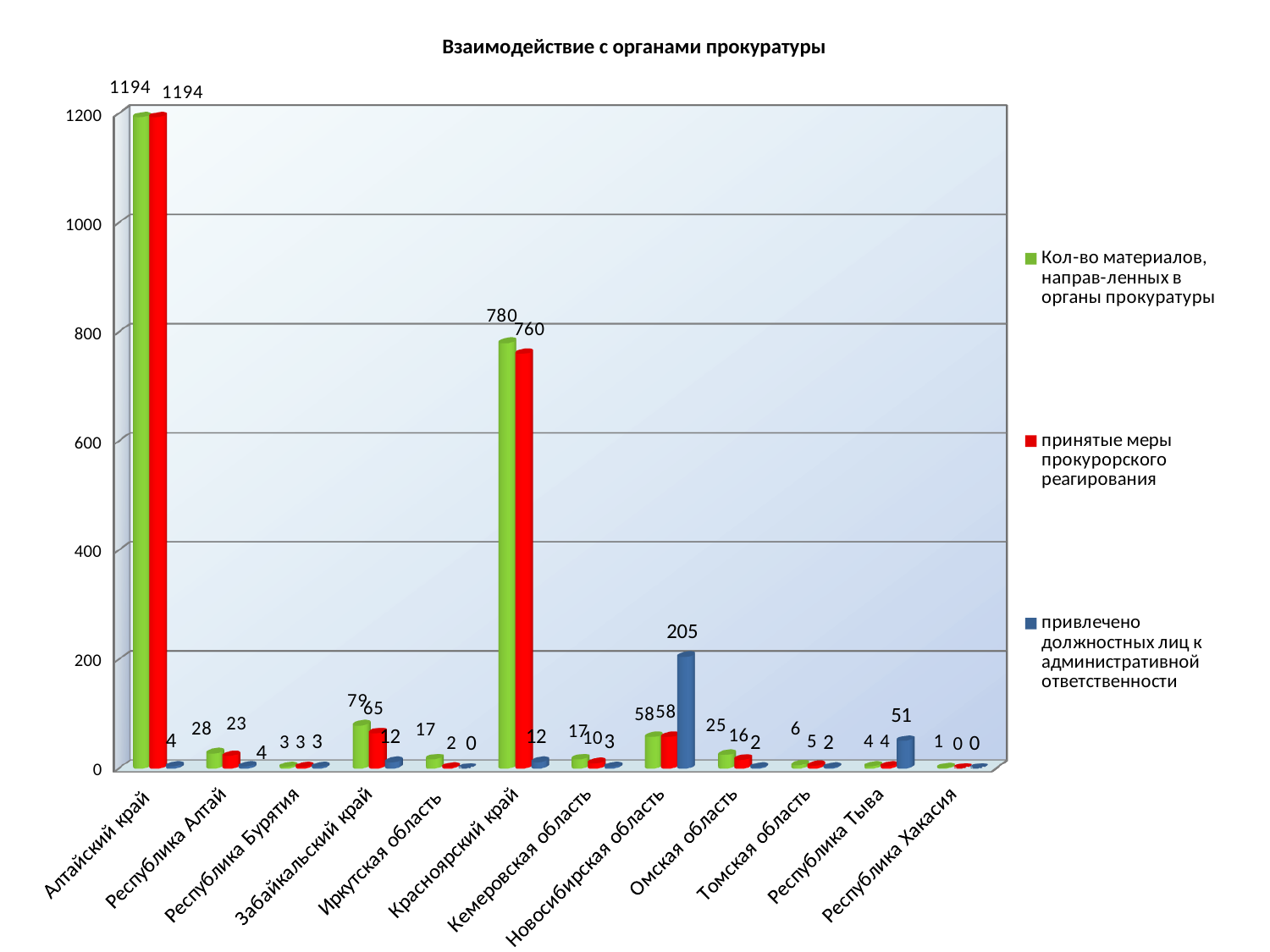
Is the value of 'Кол-во материалов, направ-ленных в органы прокуратуры' for Красноярский край greater or less than 600? greater Which is larger for Республика Тыва: 'привлечено должностных лиц к административной ответственности' or 'принятые меры прокурорского реагирования'? привлечено должностных лиц к административной ответственности What is the value of 'принятые меры прокурорского реагирования' for Забайкальский край? 65 How many regions (categories) are shown on the x axis? 12 How many series does the legend list? 3 Which region has the highest value for 'Кол-во материалов, направ-ленных в органы прокуратуры'? Алтайский край What is the difference between 'Кол-во материалов, направ-ленных в органы прокуратуры' and 'принятые меры прокурорского реагирования' for Красноярский край? 20 What is the value of 'привлечено должностных лиц к административной ответственности' for Новосибирская область? 205 What is the value of 'Кол-во материалов, направ-ленных в органы прокуратуры' for Красноярский край? 780 What is the title of the chart? Взаимодействие с органами прокуратуры What type of chart is shown on the slide? bar chart Which region has the highest value for 'привлечено должностных лиц к административной ответственности'? Новосибирская область